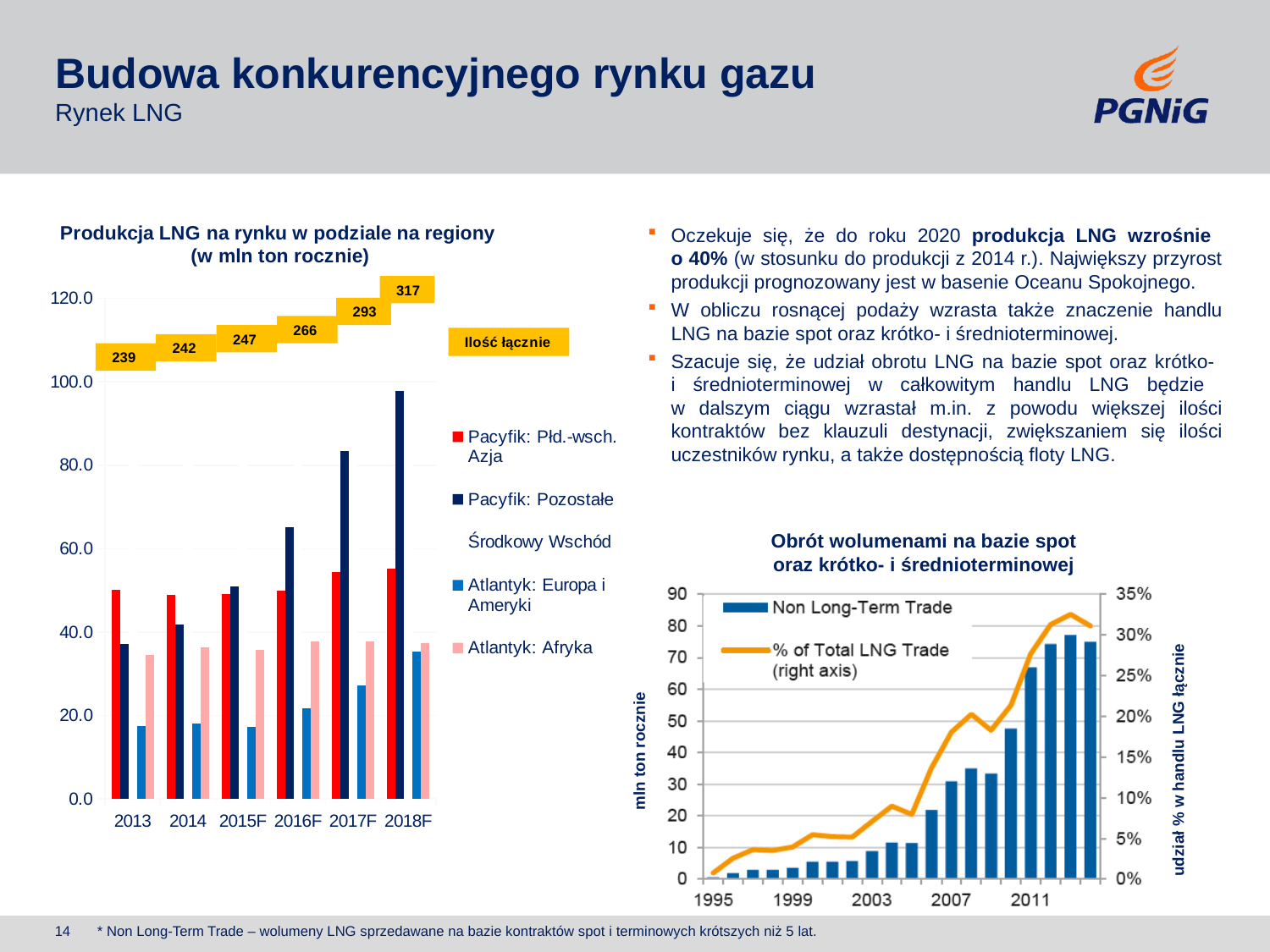
How many series does the legend of the chart 'Obrót wolumenami na bazie spot oraz krótko- i średnioterminowej' list? 2 In the chart 'Produkcja LNG na rynku w podziale na regiony', do the totals rise or fall from 2013 to 2018F? rise In the chart 'Produkcja LNG na rynku w podziale na regiony', what is the total (Ilość łącznie) shown for 2013? 239 In the chart 'Produkcja LNG na rynku w podziale na regiony', which year has the lowest total (Ilość łącznie)? 2013 What kind of chart is 'Produkcja LNG na rynku w podziale na regiony'? bar chart In the chart 'Produkcja LNG na rynku w podziale na regiony', which is larger in 2017F: Pacyfik: Pozostałe or Pacyfik: Płd.-wsch. Azja? Pacyfik: Pozostałe How many series does the legend of the chart 'Produkcja LNG na rynku w podziale na regiony' list? 5 In the chart 'Produkcja LNG na rynku w podziale na regiony', what is the total (Ilość łącznie) shown for 2018F? 317 In the chart 'Produkcja LNG na rynku w podziale na regiony', by how much does the total for 2018F exceed the total for 2013? 78 In the chart 'Produkcja LNG na rynku w podziale na regiony', is the value for Pacyfik: Pozostałe in 2018F greater or less than 80? greater In the chart 'Produkcja LNG na rynku w podziale na regiony', which year has the highest total (Ilość łącznie)? 2018F How many years are shown on the x axis of the chart 'Produkcja LNG na rynku w podziale na regiony'? 6